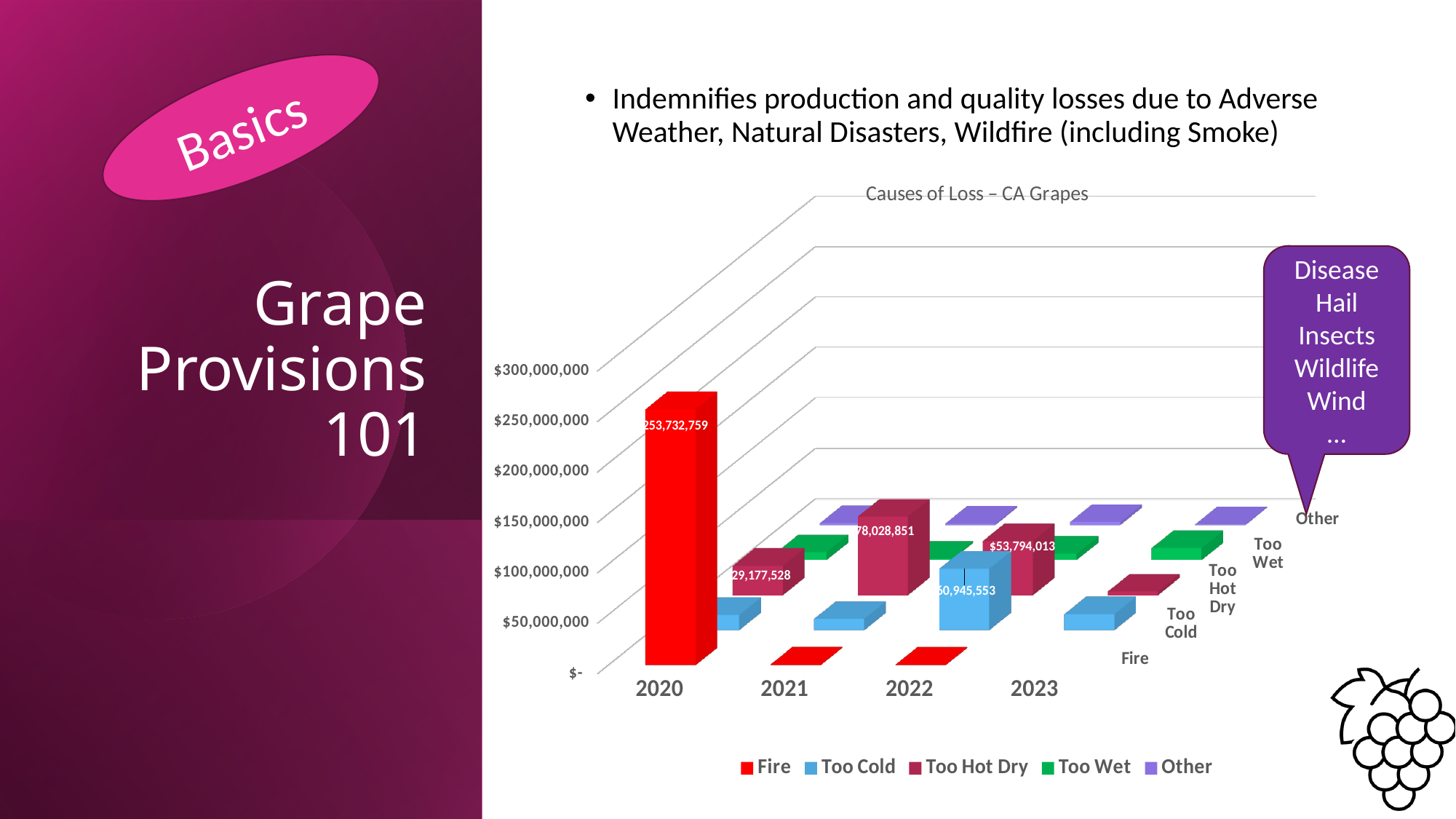
Does the Fire loss rise or fall from 2020 to 2021? fall How many years are shown along the x axis of the chart? 4 Is the value for Fire in 2020 greater or less than $200,000,000? greater What kind of chart is shown on the slide? bar chart Which is larger: Fire in 2020 or Too Hot Dry in 2022? Fire in 2020 What is the value for Fire in 2020? $253,732,759 How many series does the chart legend list? 5 Is the value for Too Hot Dry in 2023 greater or less than $100,000,000? less Which cause of loss has the highest value in 2020? Fire What is the title of the chart? Causes of Loss – CA Grapes Which year has the highest Fire loss? 2020